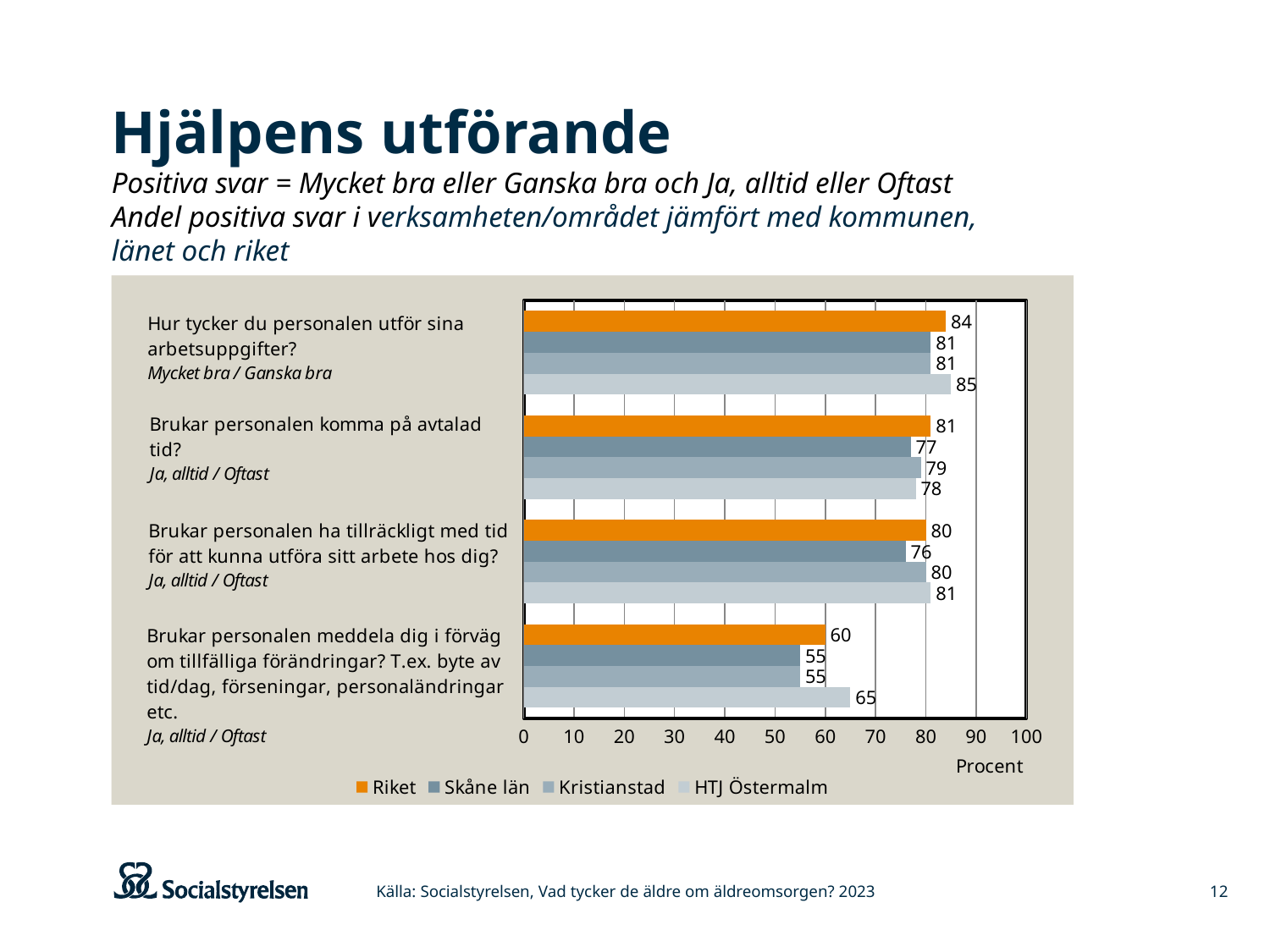
What is the value for Riket on the question "Brukar personalen komma på avtalad tid?"? 81 Which series has the lowest value on the question "Brukar personalen komma på avtalad tid?"? Skåne län What is the label of the horizontal axis? Procent What is the difference between HTJ Östermalm and Riket on the question "Brukar personalen meddela dig i förväg om tillfälliga förändringar?"? 5 What kind of chart is shown on the slide? Bar chart What is the value for Skåne län on the question "Brukar personalen ha tillräckligt med tid för att kunna utföra sitt arbete hos dig?"? 76 How many question categories are shown in the chart? 4 What is the value for Kristianstad on the question "Brukar personalen meddela dig i förväg om tillfälliga förändringar?"? 55 Which series has the highest value on the question "Brukar personalen meddela dig i förväg om tillfälliga förändringar?"? HTJ Östermalm Which is larger on the question "Brukar personalen komma på avtalad tid?": Kristianstad or HTJ Östermalm? Kristianstad What is the value for HTJ Östermalm on the question "Hur tycker du personalen utför sina arbetsuppgifter?"? 85 How many series does the legend list? 4